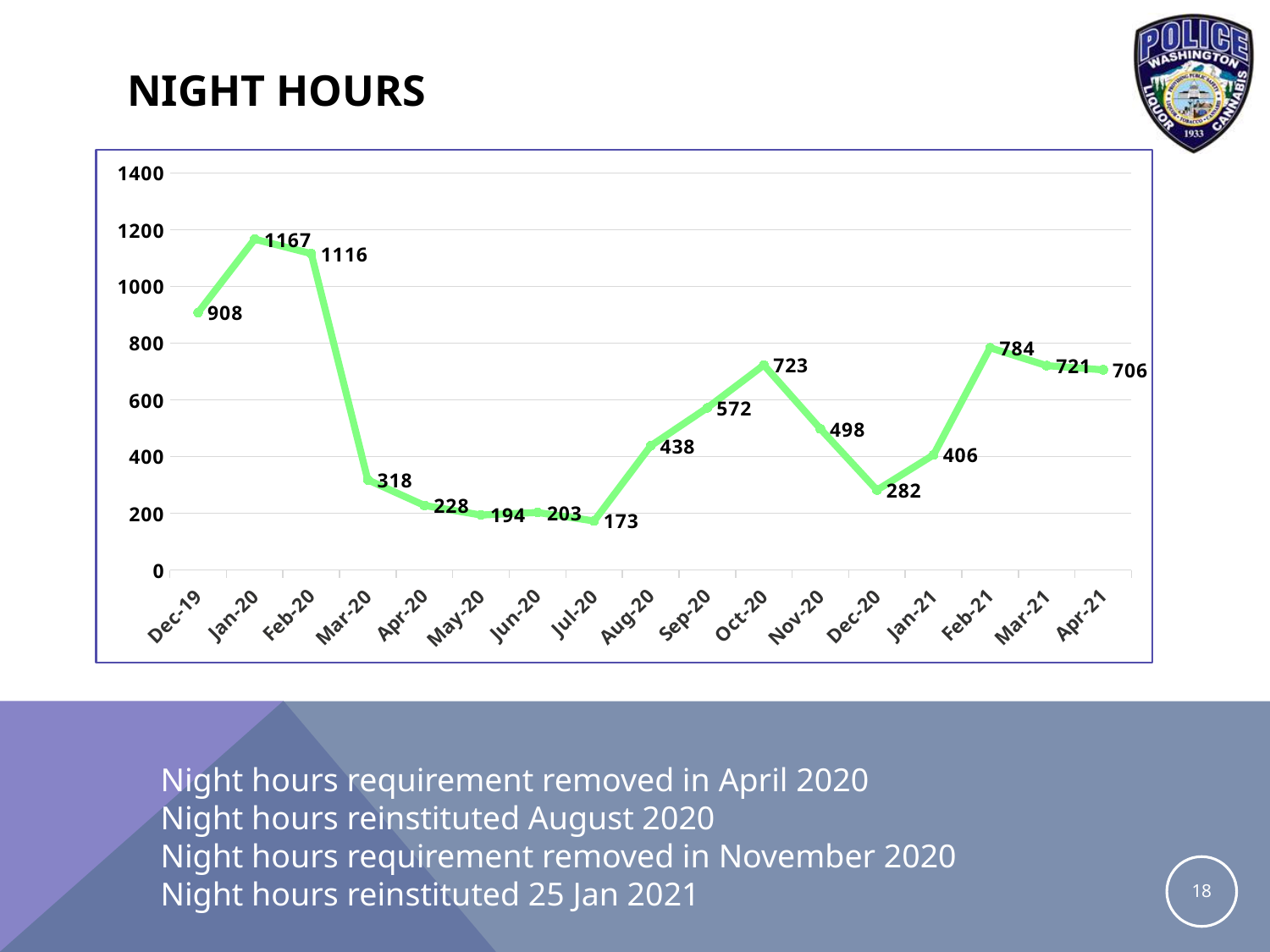
What is the value for Feb-21? 784 Is the value for Dec-19 greater or less than 800? greater What is the title of the slide containing the chart? NIGHT HOURS How many months are plotted on the x axis? 17 Which month has the highest value? Jan-20 Which is larger, the value for Oct-20 or the value for Feb-21? Feb-21 What kind of chart is shown? line chart Which month has the lowest value? Jul-20 What is the value for Jul-20? 173 Do the values rise or fall from Jul-20 to Oct-20? rise What is the difference between the values for Jan-20 and Feb-20? 51 What is the value for Jan-20? 1167